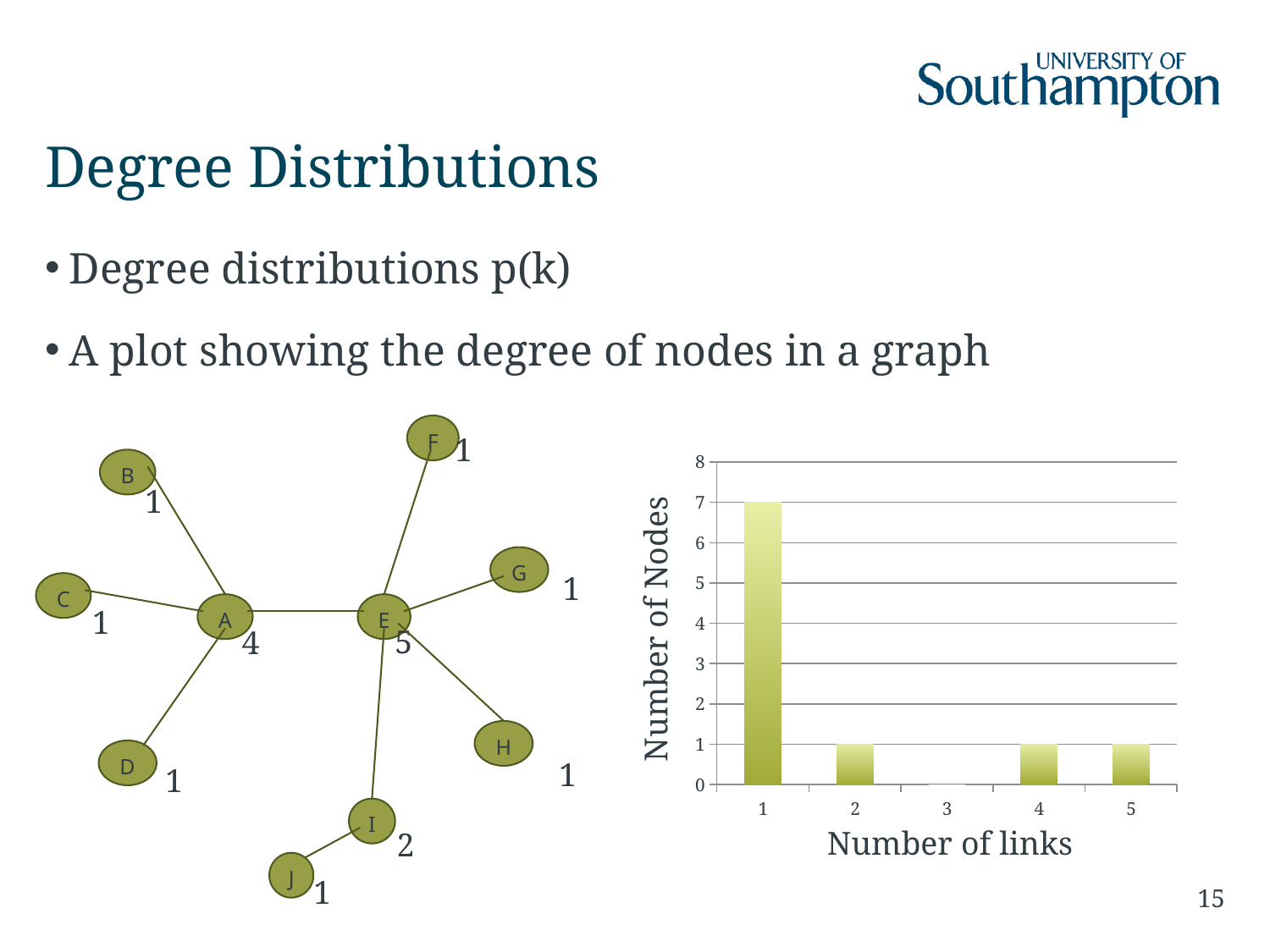
Which number of links has the highest number of nodes in the bar chart? 1 What is the difference between the number of nodes with 1 link and the number of nodes with 4 links? 6 How many nodes have 3 links according to the bar chart? 0 How many nodes have 2 links according to the bar chart? 1 How many nodes have 5 links according to the bar chart? 1 How many categories are shown on the x axis of the bar chart? 5 What is the label of the x axis of the bar chart? Number of links Which number of links has the lowest number of nodes in the bar chart? 3 What kind of chart is shown on the right of the slide? bar chart How many nodes have 1 link according to the bar chart? 7 What is the label of the y axis of the bar chart? Number of Nodes Is the number of nodes with 1 link greater or less than 5? greater